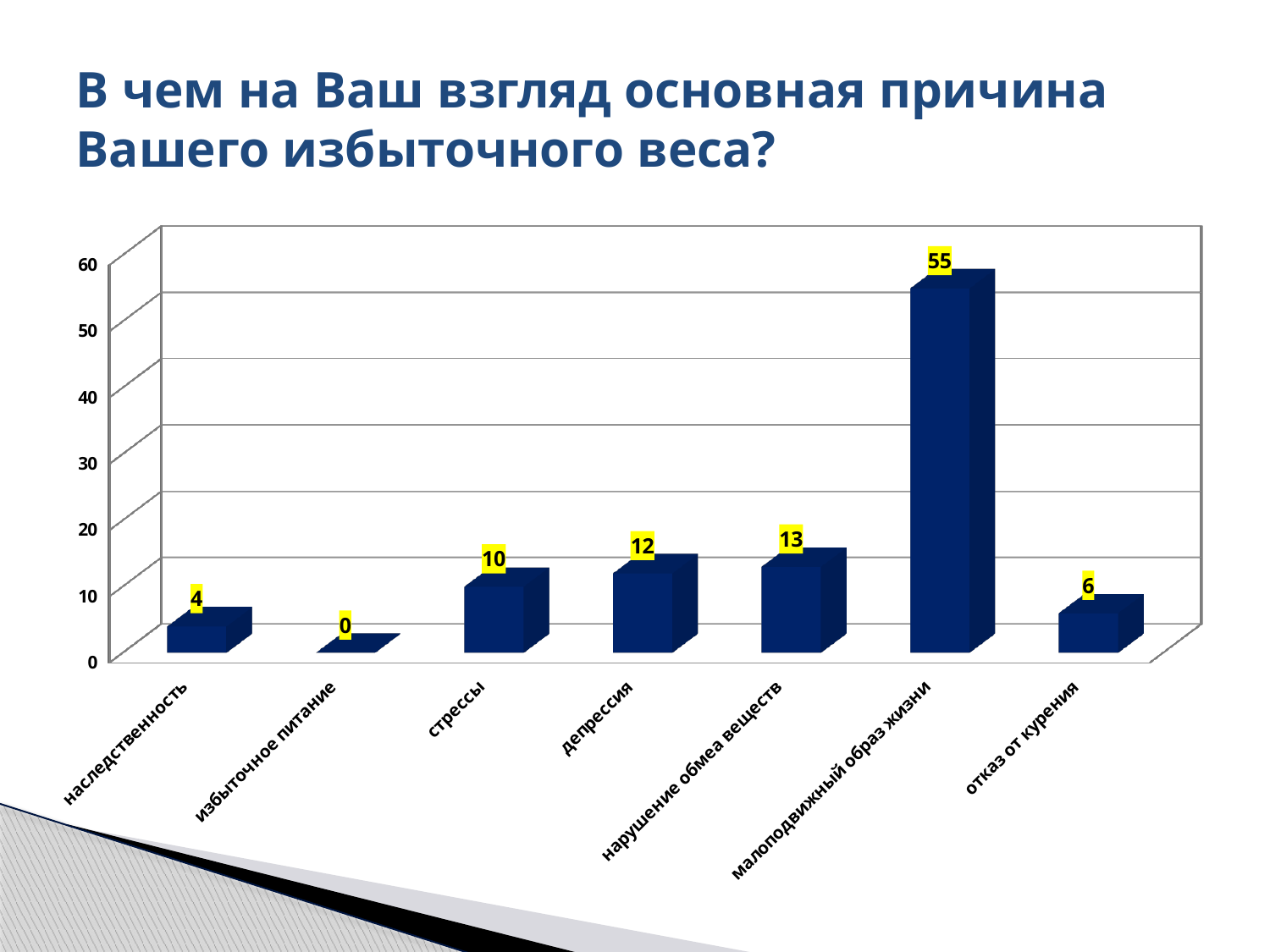
How many categories are shown on the chart? 7 Which category has the highest value? малоподвижный образ жизни What kind of chart is shown on the slide? bar chart What is the value for нарушение обмеа веществ? 13 Is the value for малоподвижный образ жизни greater or less than 50? greater What is the value for малоподвижный образ жизни? 55 What is the difference between the values for депрессия and отказ от курения? 6 What is the value for избыточное питание? 0 What is the difference between the values for малоподвижный образ жизни and нарушение обмеа веществ? 42 Which is larger, the value for стрессы or the value for депрессия? депрессия What is the value for наследственность? 4 Which category has the lowest value? избыточное питание